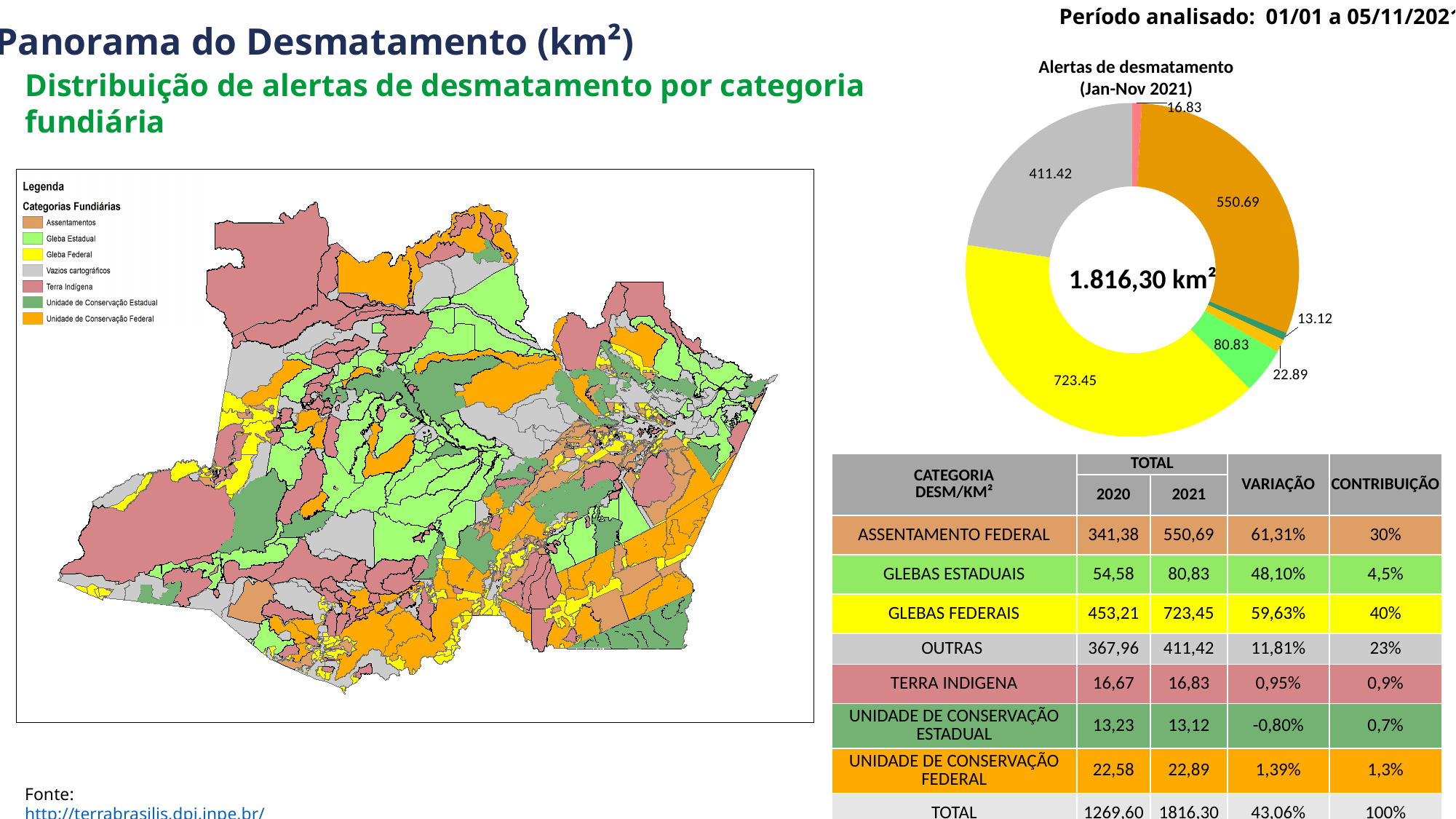
What is the value of the largest slice in the donut chart? 723.45 What total value is printed in the centre of the donut chart? 1.816,30 km² What is the value of the smallest slice in the donut chart? 13.12 What kind of chart is 'Alertas de desmatamento (Jan-Nov 2021)'? Pie (donut) chart What is the value of the yellow slice in the donut chart? 723.45 What is the title of the pie chart on the slide? Alertas de desmatamento (Jan-Nov 2021) In the donut chart, what is the difference between the yellow slice (723.45) and the orange-brown slice (550.69)? 172.76 How many slices does the donut chart have? 7 In the donut chart, which is larger: the grey slice (411.42) or the light green slice (80.83)? The grey slice (411.42) What is the value of the grey slice in the donut chart? 411.42 In the donut chart, what is the difference between the slice labelled 22.89 and the slice labelled 16.83? 6.06 What is the value of the light green slice in the donut chart? 80.83